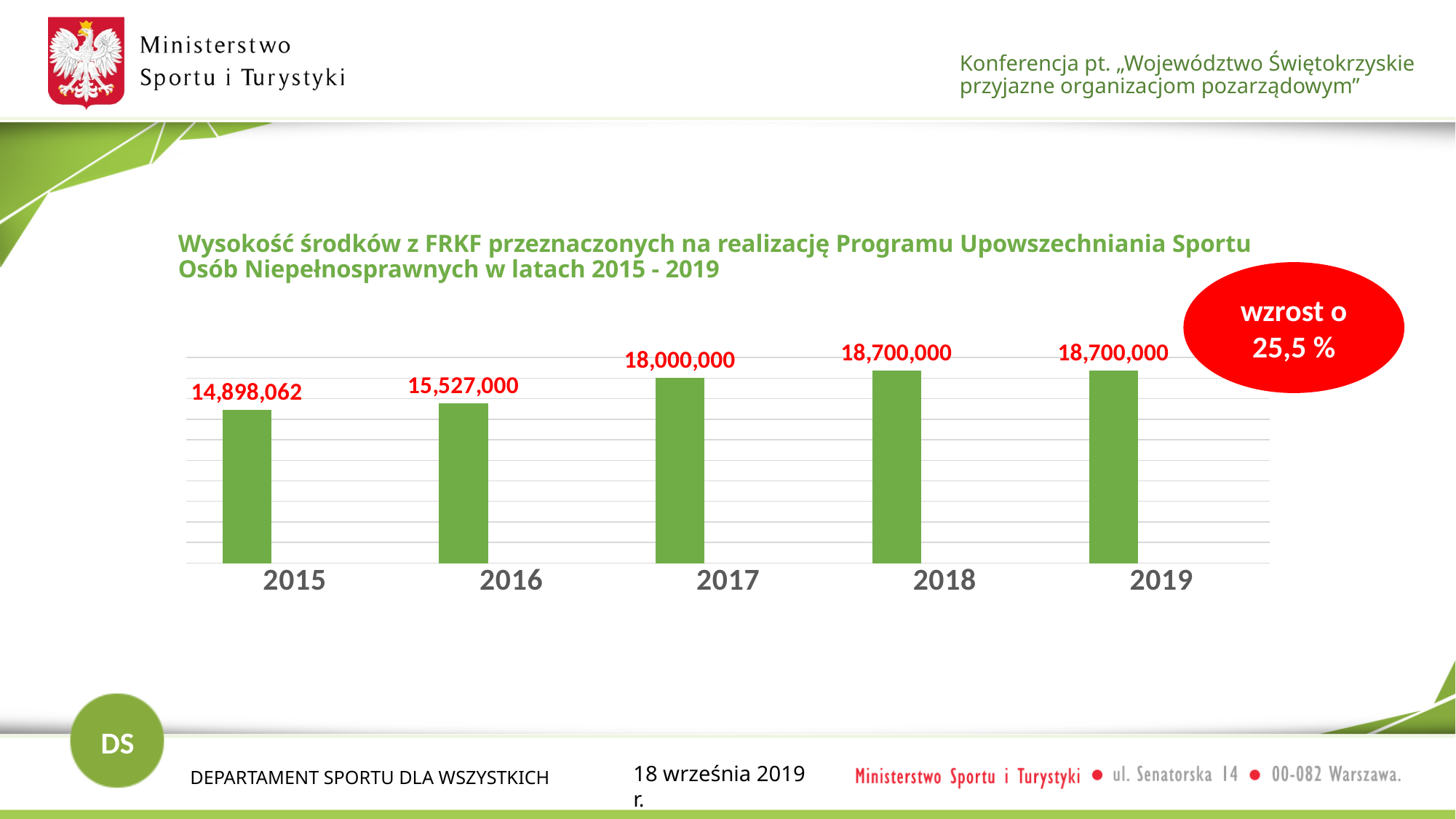
What is the difference between the values for 2018 and 2017? 700,000 What is the difference between the values for 2019 and 2015? 3,801,938 Which is larger, the value for 2016 or the value for 2017? 2017 What is the value shown for 2016? 15,527,000 What is the value shown for 2019? 18,700,000 What is the value shown for 2015? 14,898,062 Which two years share the highest value in the chart? 2018 and 2019 What is the difference between the values for 2017 and 2016? 2,473,000 What is the value shown for 2017? 18,000,000 Which year has the lowest value in the chart? 2015 What kind of chart is shown on the slide? Bar chart How many years are shown on the x axis of the chart? 5